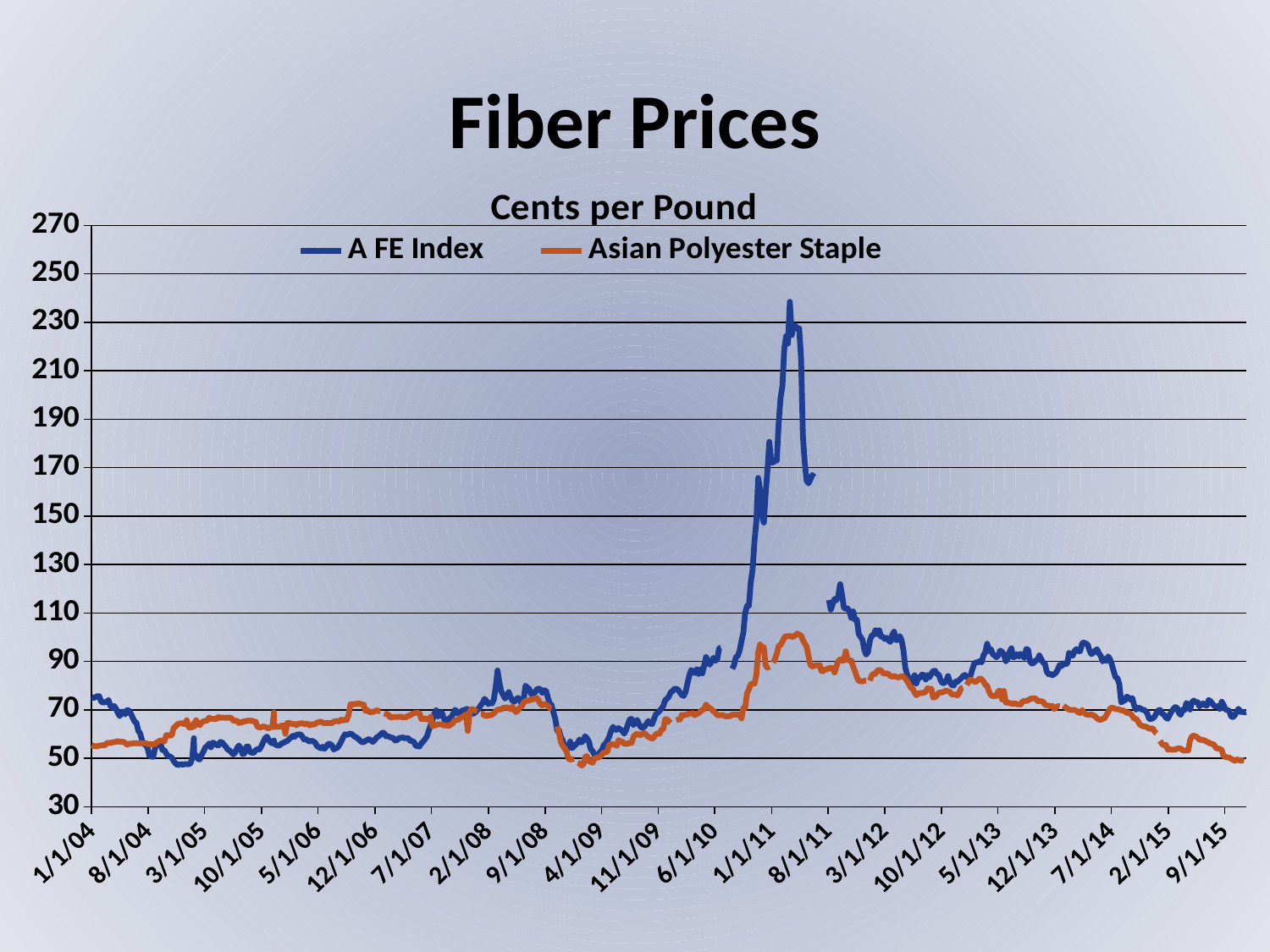
What kind of chart is shown on the slide? line chart Which colour is used for the A FE Index line? blue Is the peak value of Asian Polyester Staple in 2011 greater or less than 110? less Is the peak value of the A FE Index in 2011 greater or less than 210? greater How many series does the legend list? 2 Is the value of Asian Polyester Staple at 9/1/15 greater or less than 70? less Which series reaches the highest value on the chart? A FE Index Around 3/1/05, which series has the higher value, A FE Index or Asian Polyester Staple? Asian Polyester Staple What is the title shown above the chart's plot area? Cents per Pound Does the Asian Polyester Staple line rise or fall between 7/1/14 and 9/1/15? fall Around 8/1/11, which series has the higher value, A FE Index or Asian Polyester Staple? A FE Index